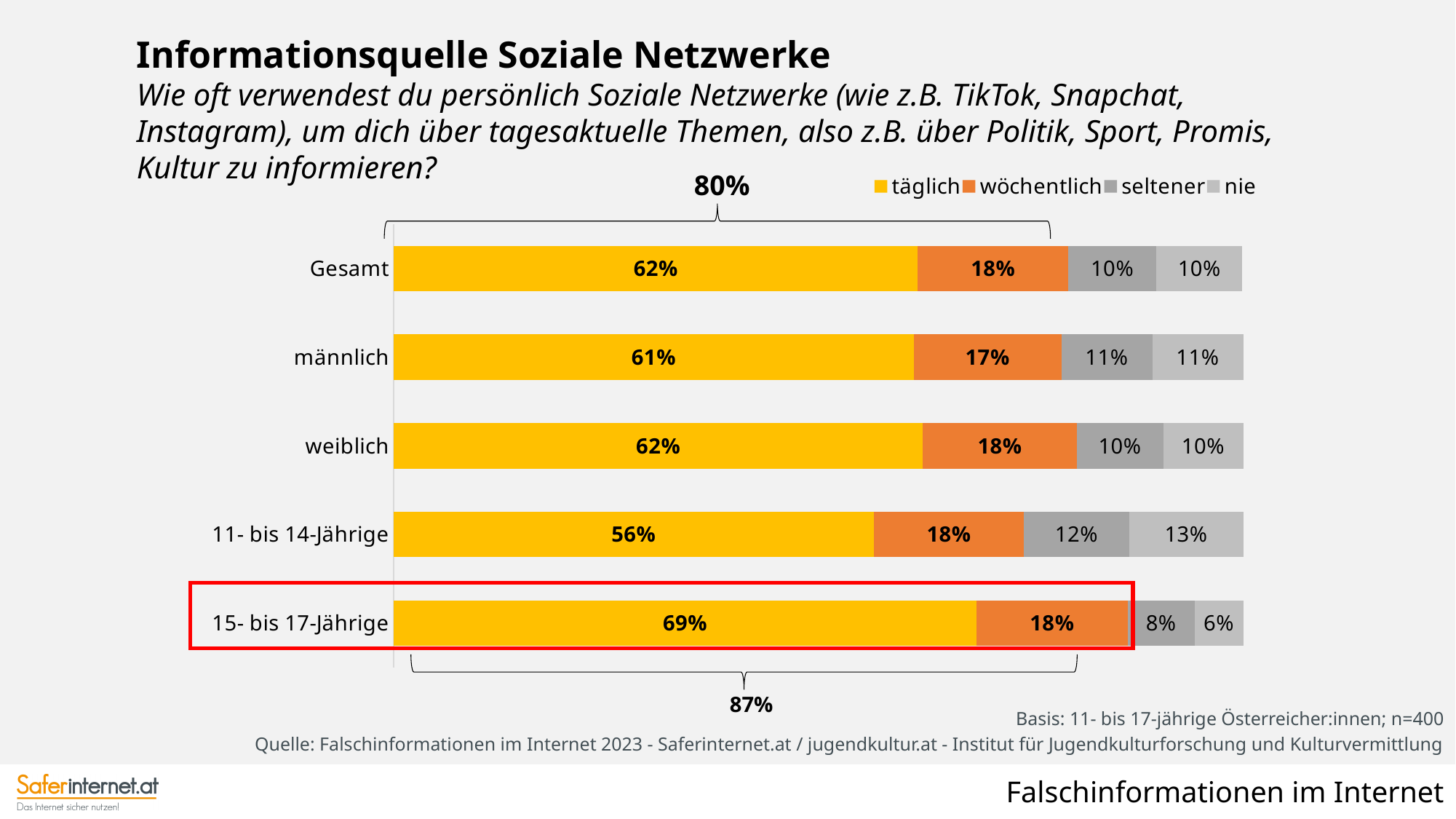
What is the combined 'täglich' and 'wöchentlich' share for '15- bis 17-Jährige'? 87% Which category has the highest 'täglich' value? 15- bis 17-Jährige What is the 'seltener' value for '15- bis 17-Jährige'? 8% How many series does the legend list? 4 What is the difference between the 'täglich' values for '15- bis 17-Jährige' and '11- bis 14-Jährige'? 13 percentage points What kind of chart is shown on the slide? Stacked bar chart Which category has the lowest 'täglich' value? 11- bis 14-Jährige What is the 'nie' value for '11- bis 14-Jährige'? 13% What is the 'wöchentlich' value for 'männlich'? 17% How many categories are shown on the chart? 5 What percentage of the 'Gesamt' group uses social networks 'täglich' to inform themselves about current topics? 62% Which is larger: the 'nie' value for 'männlich' or the 'nie' value for '15- bis 17-Jährige'? männlich